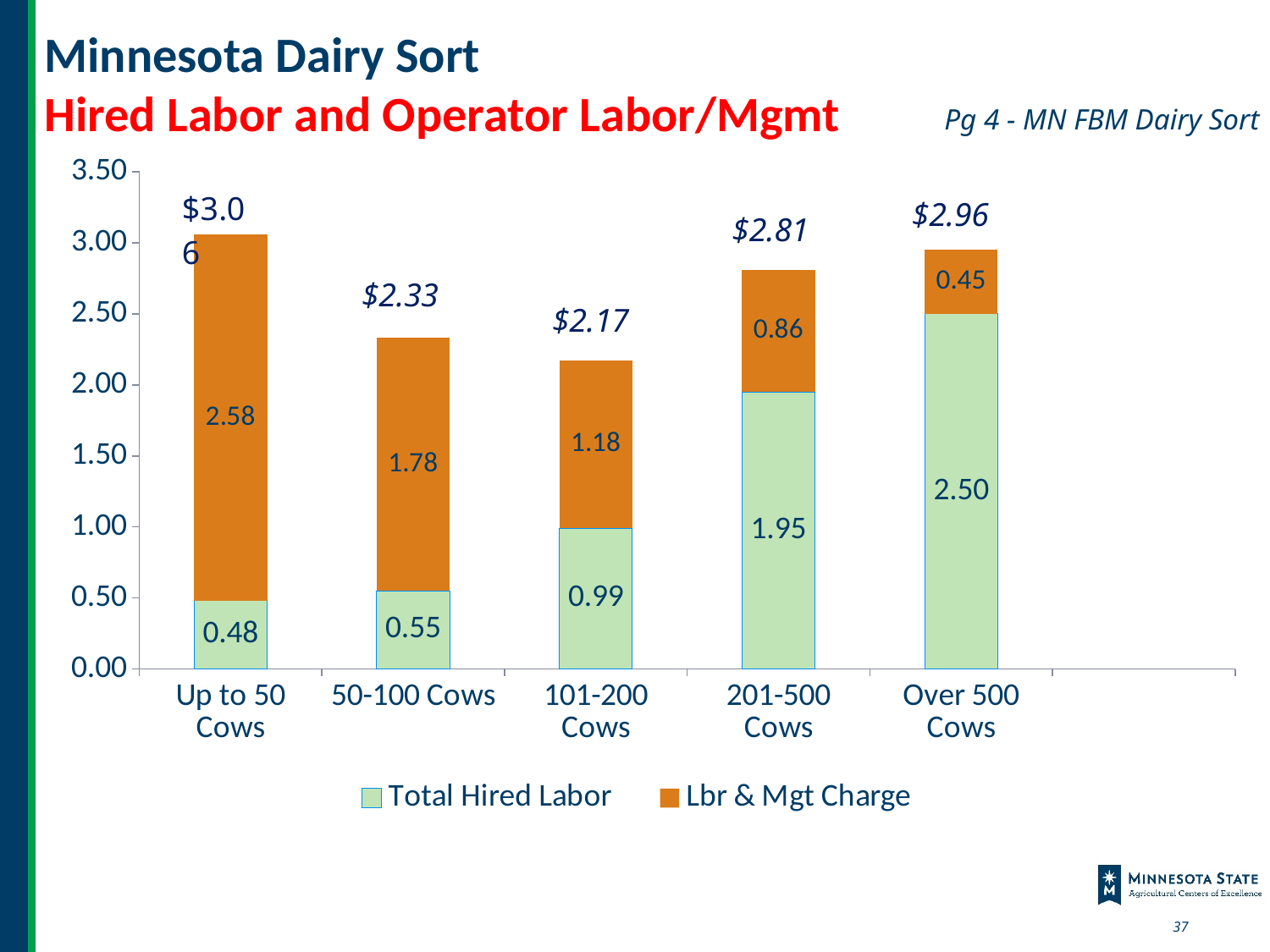
What is the total labelled above the stacked bar for 201-500 Cows? $2.81 Which category has the highest Total Hired Labor value? Over 500 Cows What is the total labelled above the stacked bar for 101-200 Cows? $2.17 How many series does the legend list? 2 What is the Total Hired Labor value for the 201-500 Cows category? 1.95 Which is larger: the Total Hired Labor value for 101-200 Cows or for 50-100 Cows? 101-200 Cows Which category has the lowest Lbr & Mgt Charge value? Over 500 Cows How many categories are shown on the x axis? 5 What is the Lbr & Mgt Charge value for the Up to 50 Cows category? 2.58 What kind of chart is shown on the slide? Stacked bar chart What is the difference between the Lbr & Mgt Charge values for 50-100 Cows and 101-200 Cows? 0.60 What is the Total Hired Labor value for the Over 500 Cows category? 2.50